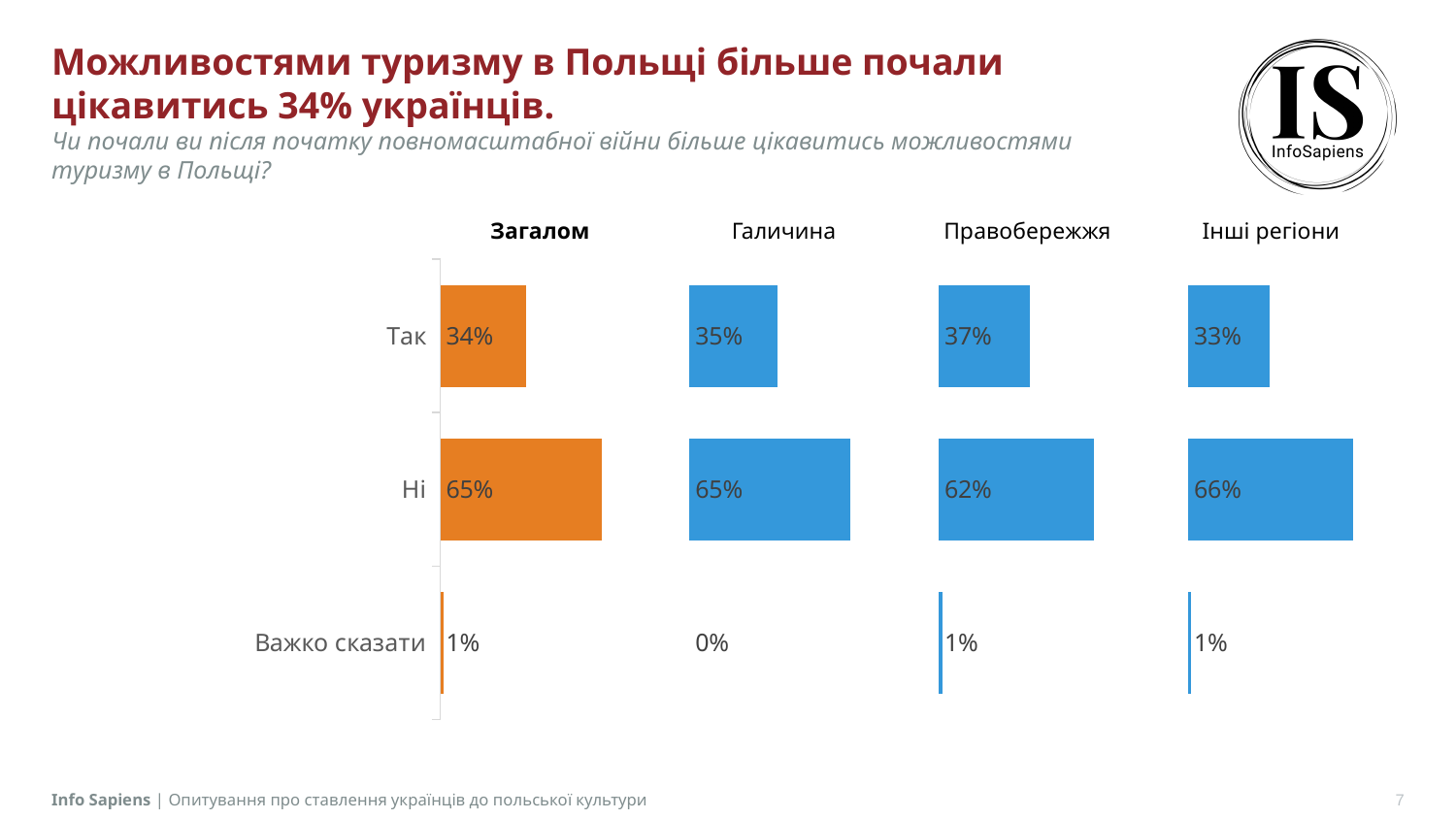
In the Інші регіони chart, which category has the highest value? Ні In the Галичина chart, what is the value for Важко сказати? 0% How many categories does the Загалом chart show? 3 In the Загалом chart, what is the value for Так? 34% In the Правобережжя chart, which category has the lowest value? Важко сказати In the Правобережжя chart, what is the difference between the values for Ні and Так? 25% In the Інші регіони chart, what is the value for Важко сказати? 1% In the Правобережжя chart, what is the value for Так? 37% In the Загалом chart, what is the difference between the values for Ні and Так? 31% Which is larger: the value for Так in the Правобережжя chart or the value for Так in the Інші регіони chart? Правобережжя What kind of chart is the Загалом chart? Bar chart In the Галичина chart, what is the value for Ні? 65%